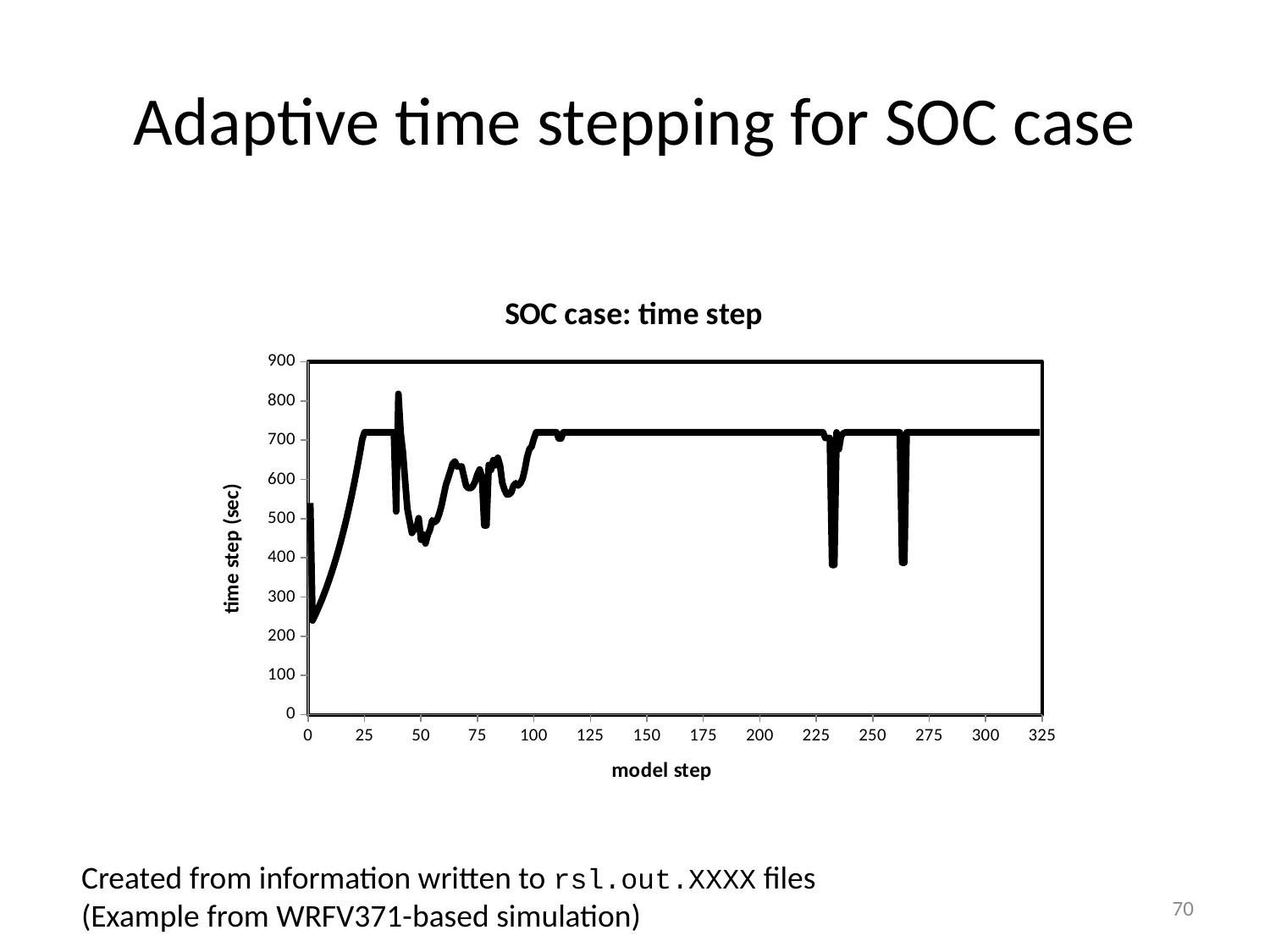
How many data series are plotted in the chart? 1 Is the time step at model step 150 greater or less than 600? greater Is the time step at model step 200 larger or smaller than the time step at model step 50? larger Is the time step at model step 10 greater or less than 500? less Is the lowest time step in the dip near model step 232 greater or less than 500? less What is the label of the y axis of the chart? time step (sec) What is the title of the chart? SOC case: time step Between model step 0 and model step 25, does the time step rise or fall? rise What kind of chart is shown on the slide? line chart